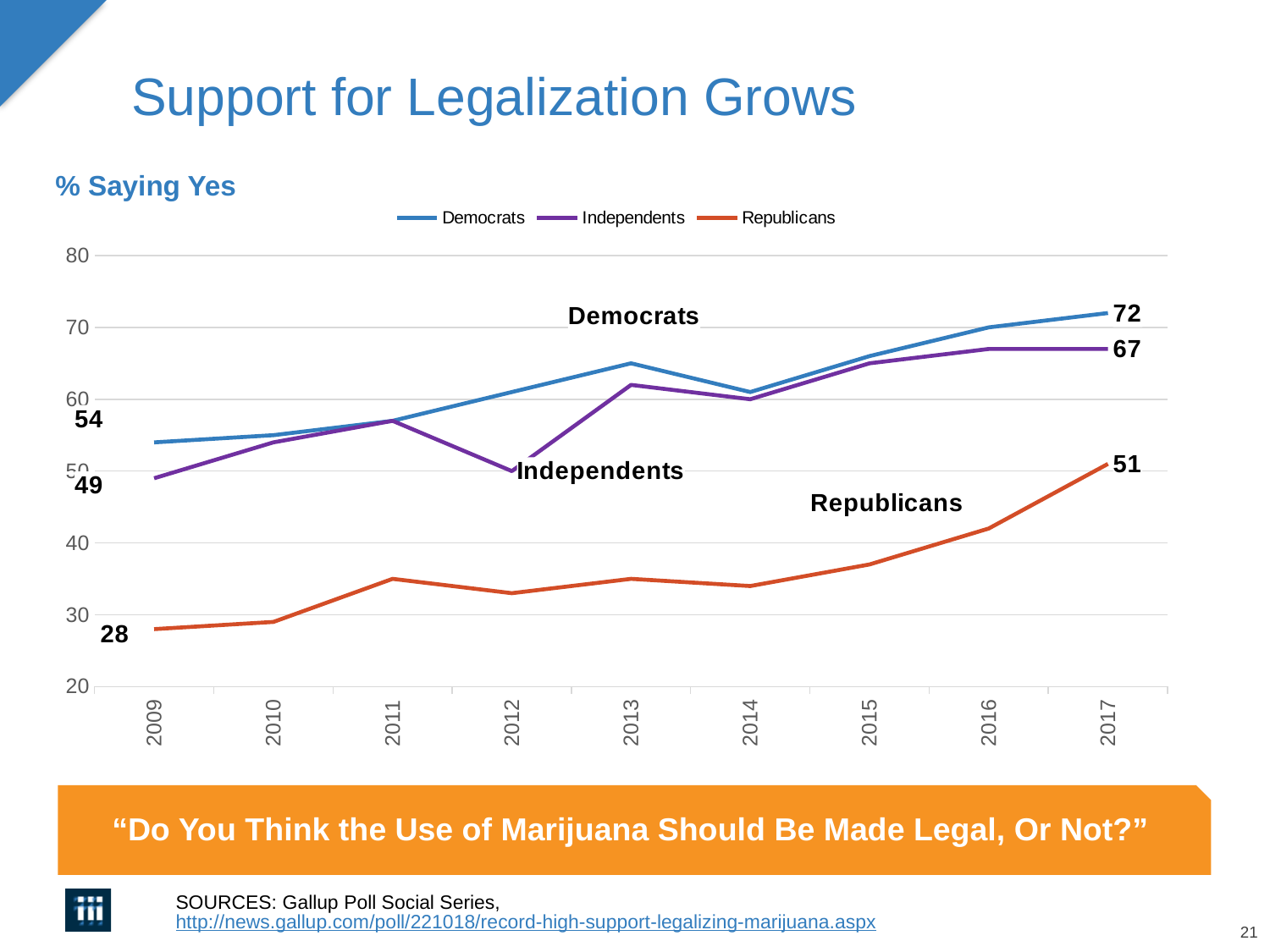
What is the value for Democrats in 2017? 72 What is the value for Republicans in 2017? 51 How many years are shown on the x axis? 9 By how much did the Republicans value increase from 2009 to 2017? 23 Which series has the lowest value in 2017? Republicans What is the value for Independents in 2009? 49 What is the value for Democrats in 2009? 54 What kind of chart is shown on the slide? line chart What is the value for Independents in 2017? 67 What is the value for Republicans in 2009? 28 How many series does the legend list? 3 Is the value for Republicans in 2013 greater or less than 40? less